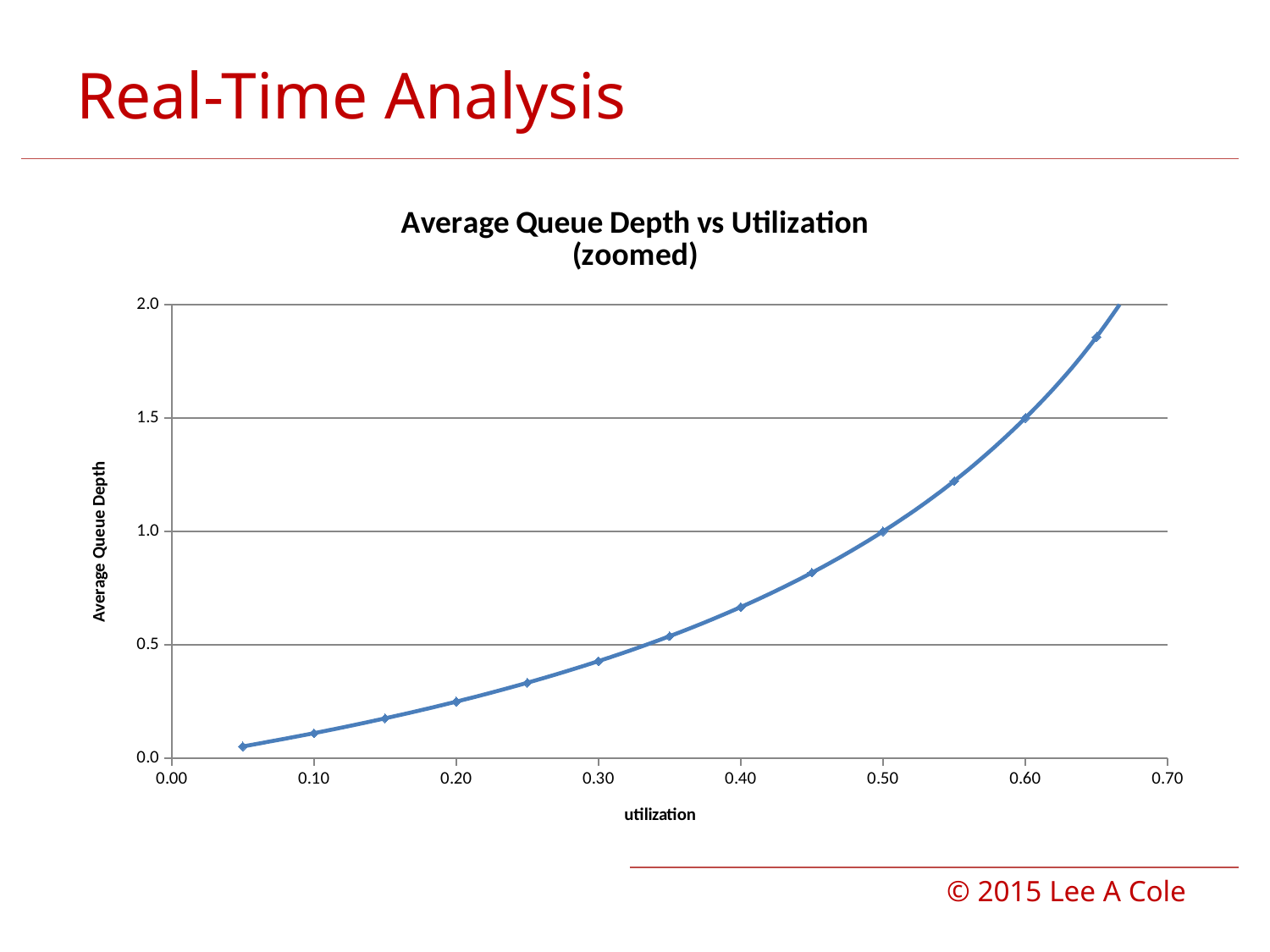
Is the average queue depth at a utilization of 0.65 greater or less than 1.5? greater What is the label of the vertical axis? Average Queue Depth Is the average queue depth at a utilization of 0.55 greater or less than 1.0? greater Which is larger, the average queue depth at a utilization of 0.20 or at 0.45? 0.45 Is the average queue depth at a utilization of 0.30 greater or less than 0.5? less What kind of chart is shown on the slide? line chart At which plotted utilization value is the average queue depth lowest? 0.05 Does the average queue depth rise or fall as utilization increases? rises What is the average queue depth at a utilization of 0.50? 1.0 What is the average queue depth at a utilization of 0.60? 1.5 What is the title of the chart? Average Queue Depth vs Utilization (zoomed)